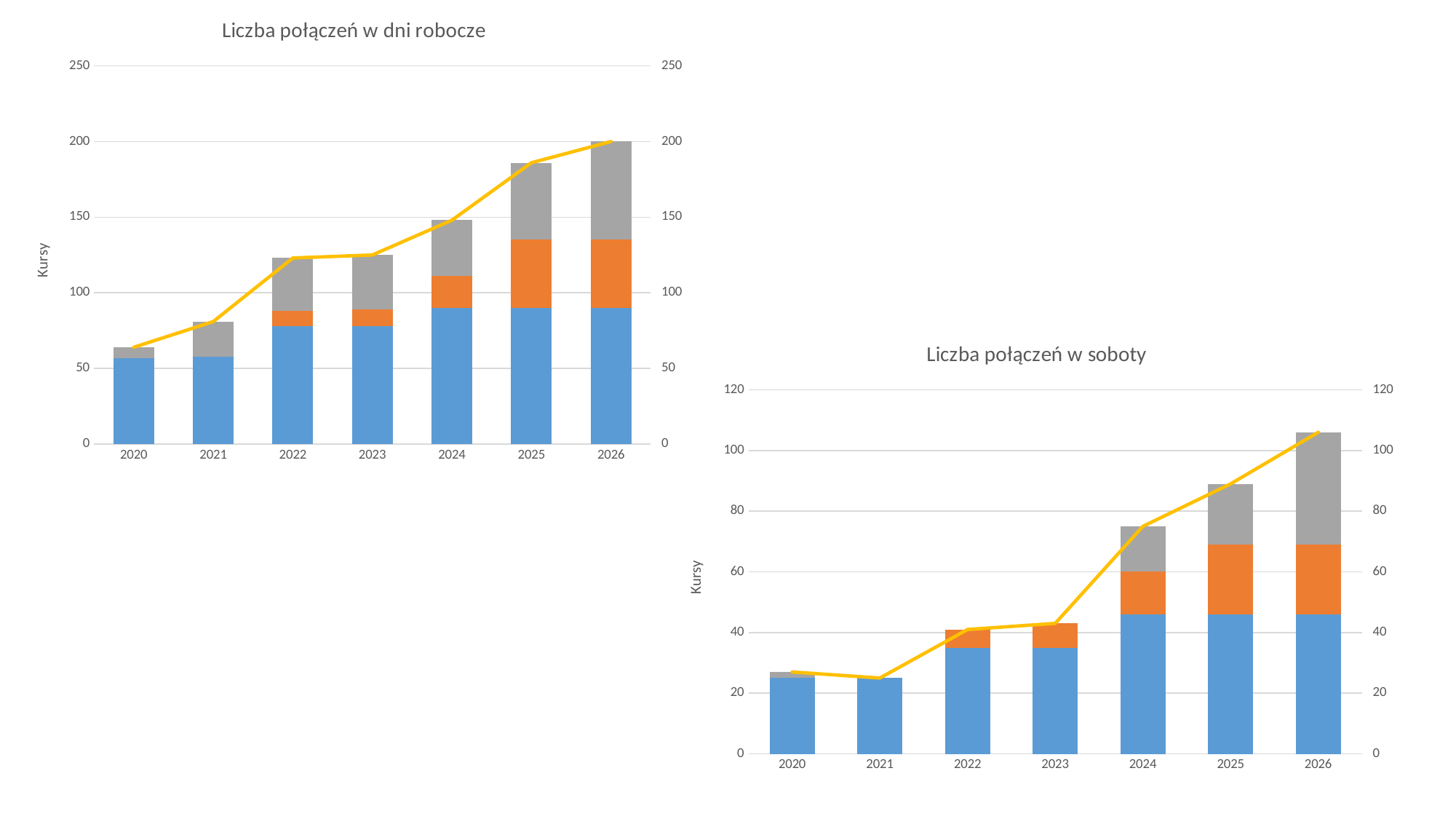
In the chart "Liczba połączeń w dni robocze", which year has the larger total, 2023 or 2025? 2025 In the chart "Liczba połączeń w soboty", which year has the larger total, 2022 or 2024? 2024 In the chart "Liczba połączeń w dni robocze", how many years are shown on the x axis? 7 In the chart "Liczba połączeń w dni robocze", which year has the shortest stacked bar? 2020 What kind of chart is "Liczba połączeń w dni robocze"? combination bar and line chart In the chart "Liczba połączeń w dni robocze", is the total for 2021 greater or less than 100? less In the chart "Liczba połączeń w soboty", is the total for 2024 greater or less than 60? greater In the chart "Liczba połączeń w soboty", which year has the tallest stacked bar? 2026 In the chart "Liczba połączeń w dni robocze", do the totals generally rise or fall from 2020 to 2026? rise In the chart "Liczba połączeń w dni robocze", which year has the tallest stacked bar? 2026 What is the label on the vertical axis of the chart "Liczba połączeń w soboty"? Kursy In the chart "Liczba połączeń w dni robocze", is the total for 2024 greater or less than 100? greater